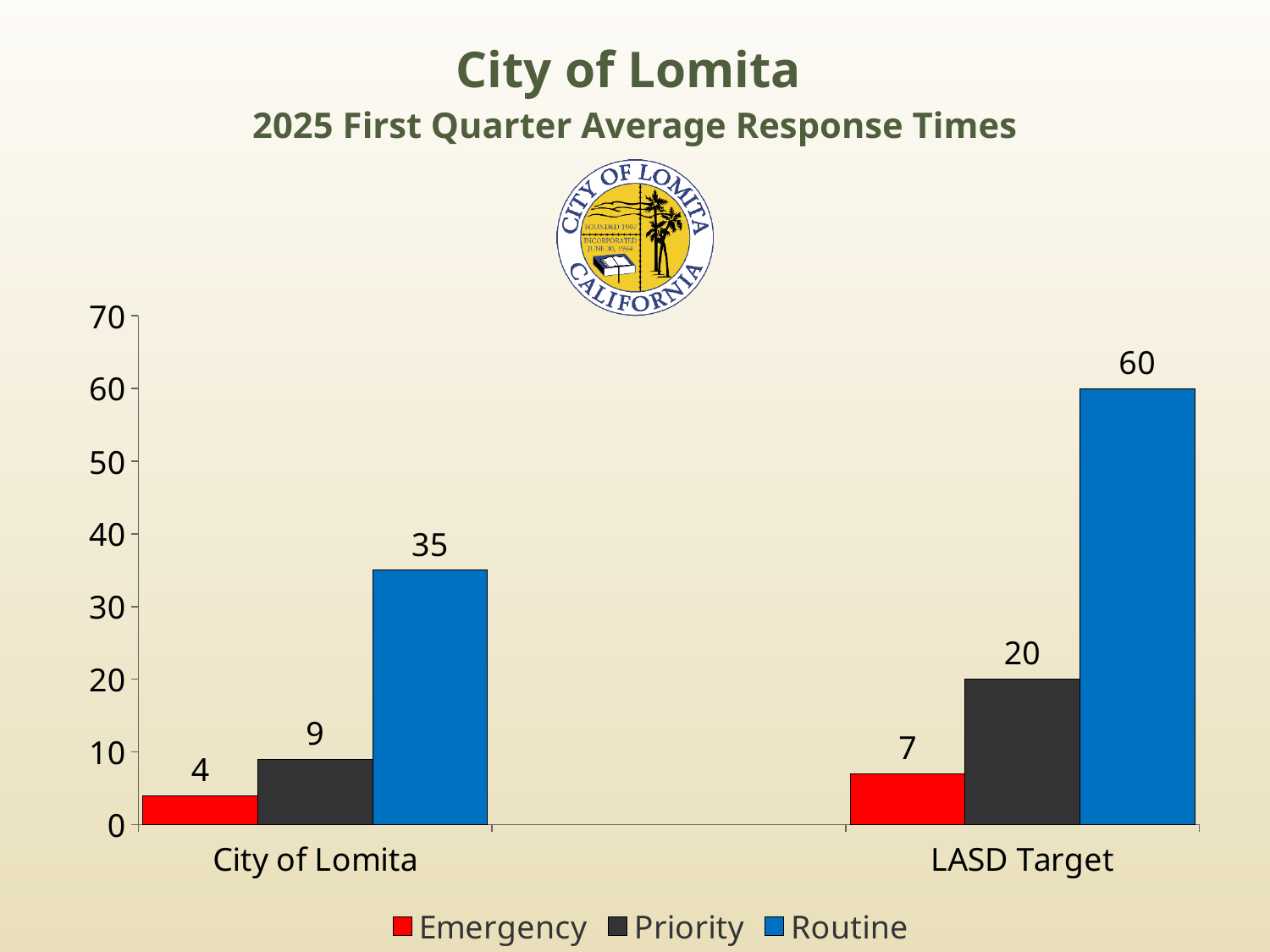
What kind of chart is shown on the slide? bar chart What is the Routine response time for LASD Target? 60 How many categories are shown on the x axis? 2 Which is larger, the Priority value for City of Lomita or for LASD Target? LASD Target How many series does the legend list? 3 Is the Routine value for City of Lomita greater or less than 40? less What colour represents the Emergency series in the legend? red What is the difference between the Routine values for LASD Target and City of Lomita? 25 What is the Priority response time for City of Lomita? 9 Which series has the lowest value for City of Lomita? Emergency What is the Emergency response time for City of Lomita? 4 Which series has the highest value for LASD Target? Routine